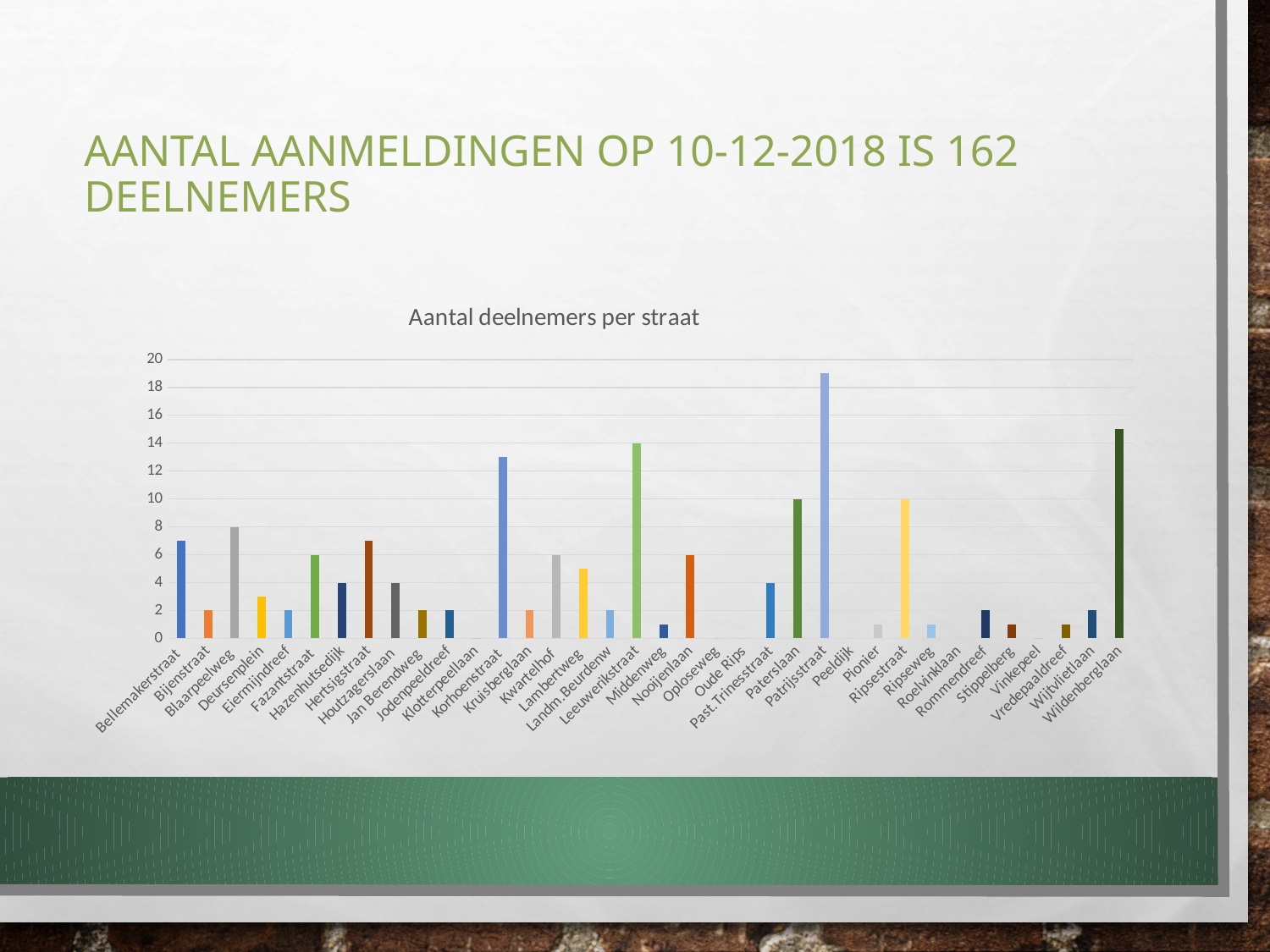
What is the value for Paterslaan? 10 What is the value for Leeuwerikstraat? 14 Is the value for Patrijsstraat greater or less than 18? greater What is the value for Blaarpeelweg? 8 What is the value for Ripsestraat? 10 How many streets are shown on the x axis? 36 Which is larger, the value for Korhoenstraat or the value for Wildenberglaan? Wildenberglaan Which street has the highest number of participants? Patrijsstraat Is the value for Wildenberglaan greater or less than 14? greater What is the title of the chart? Aantal deelnemers per straat What is the difference between the values for Leeuwerikstraat and Paterslaan? 4 What kind of chart is shown on the slide? bar chart